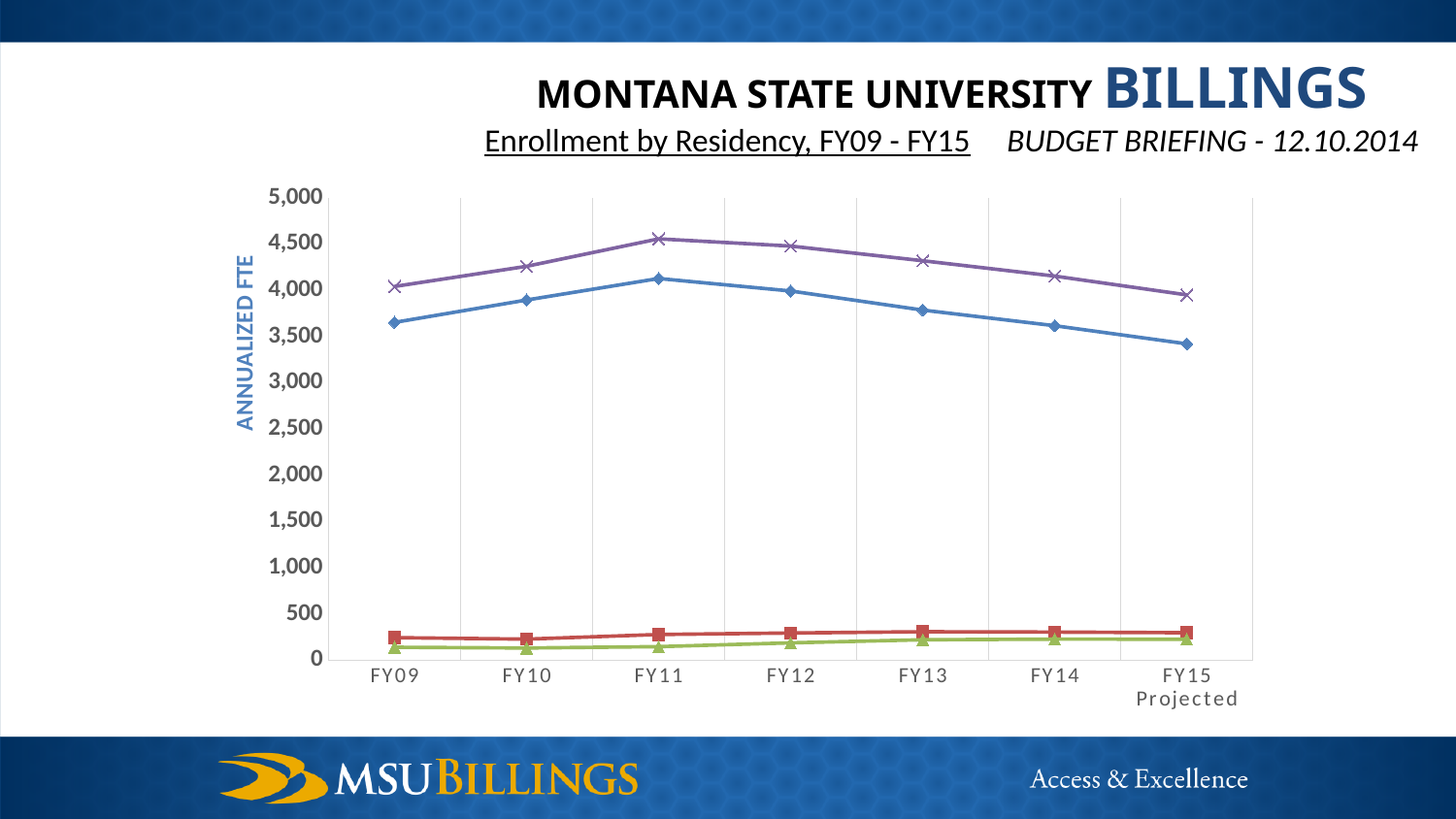
At FY12, which is larger: the purple line with x markers or the blue line with diamond markers? The purple line with x markers How many fiscal-year categories are shown along the x axis? 7 How many lines are plotted on the chart? 4 What is the label on the vertical axis of the chart? ANNUALIZED FTE What kind of chart is shown on the slide? Line chart In which fiscal year does the purple line with x markers reach its highest value? FY11 What is the title of the chart? Enrollment by Residency, FY09 - FY15 In which fiscal year does the blue line with diamond markers reach its lowest value? FY15 Projected At FY09, which is larger: the red line with square markers or the green line with triangle markers? The red line with square markers Is the value of the red line with square markers at FY13 greater or less than 500? less Is the value of the blue line with diamond markers at FY11 greater or less than 4,000? greater Does the blue line with diamond markers rise or fall from FY11 to FY15 Projected? fall